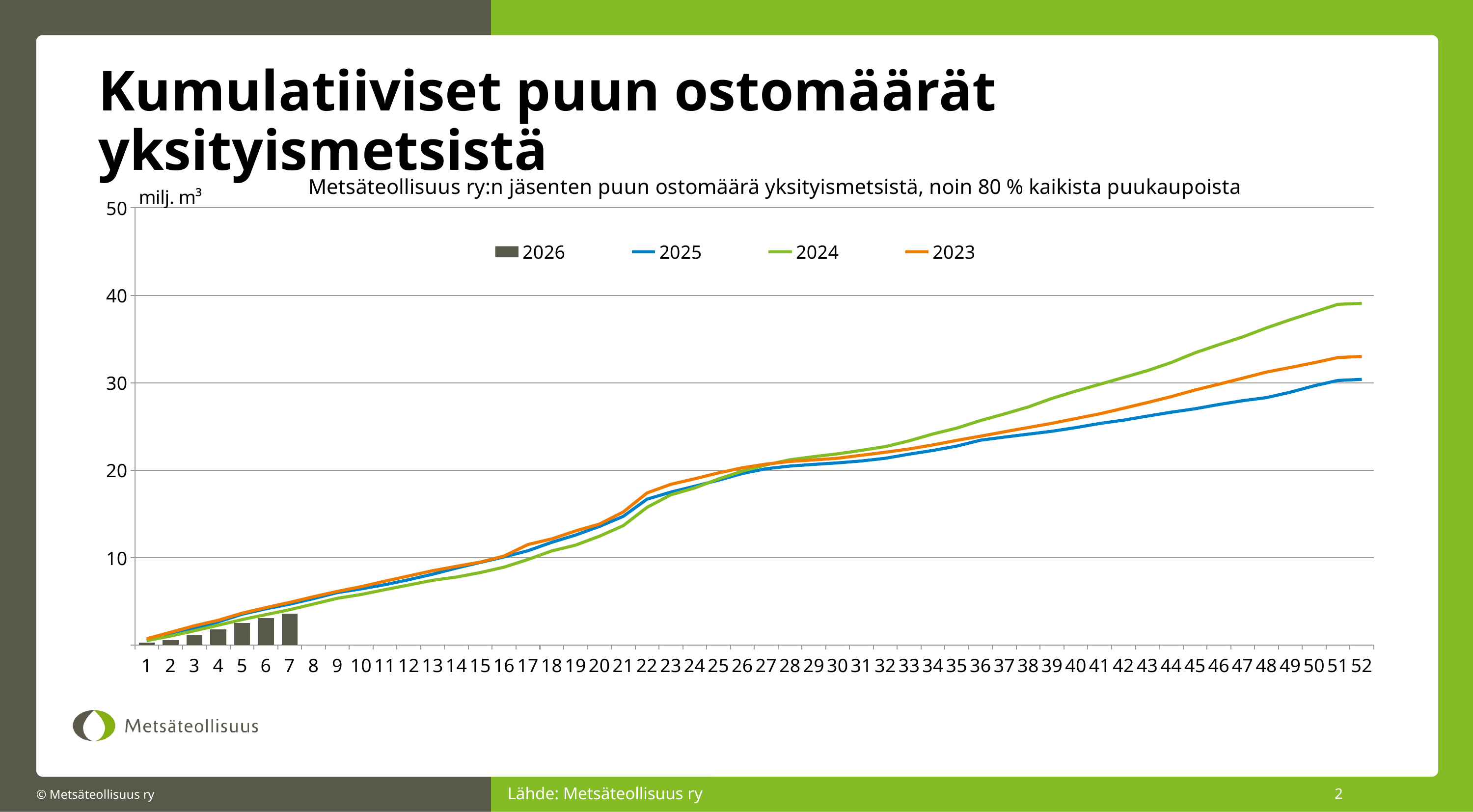
For how many weeks are 2026 bars plotted? 7 How many weeks are shown on the x axis? 52 What unit is shown on the vertical axis? milj. m³ Which year has the highest cumulative value at week 52? 2024 Is the value for 2024 at week 52 greater or less than 30? greater Is the value for 2026 at week 7 greater or less than 10? less Is the value for 2023 at week 40 greater or less than 30? less How many series does the legend list? 4 Which year has the lowest cumulative value at week 52? 2025 Which series is shown as bars rather than a line? 2026 At week 45, which is larger: the value for 2024 or for 2023? 2024 Do the values for 2025 rise or fall along the x axis? rise